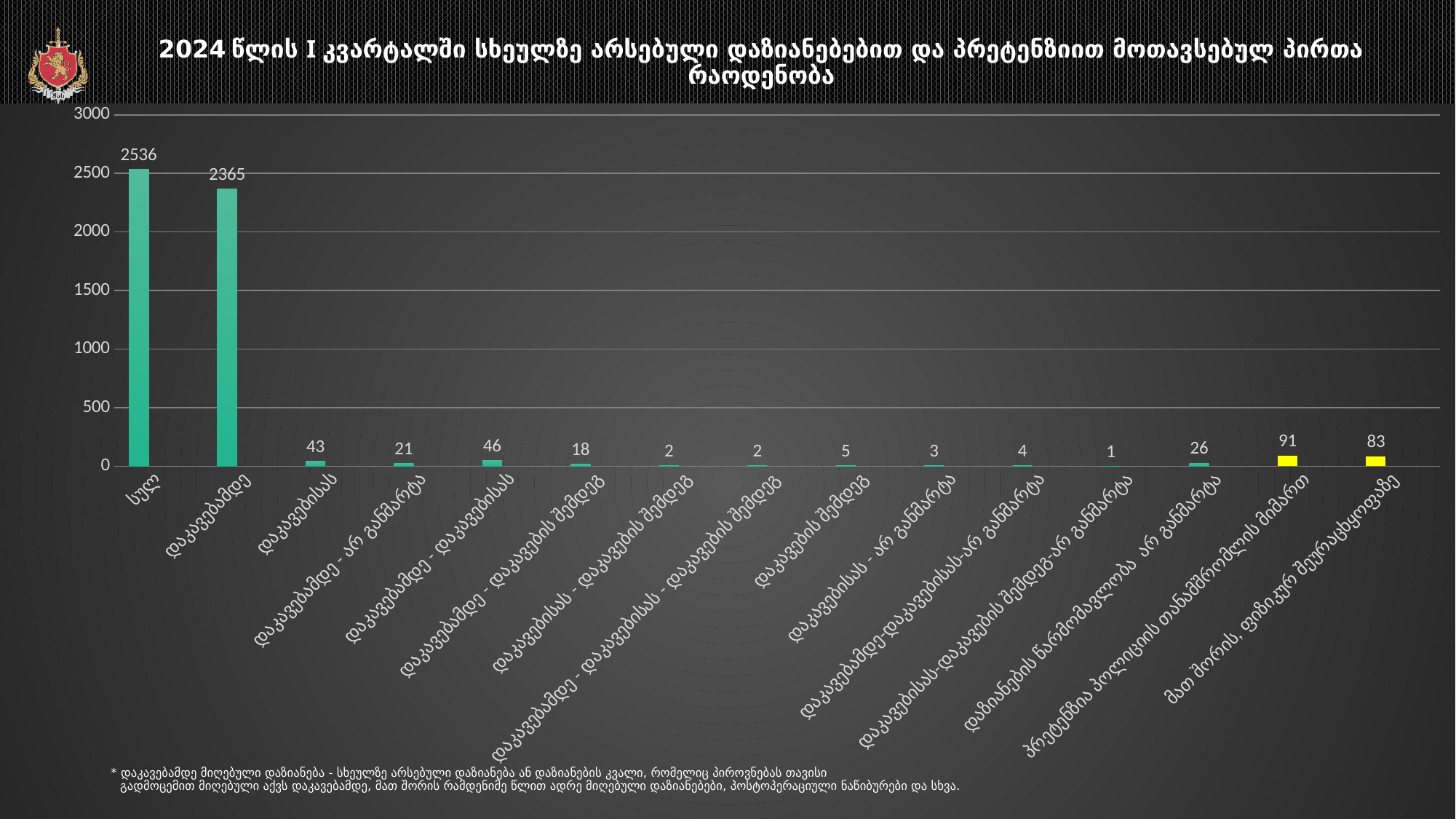
What is the value for the category "სულ"? 2536 Which category has the lowest value? დაკავებისას-დაკავების შემდეგ-არ განმარტა What is the value for the category "მათ შორის, ფიზიკურ შეურაცხყოფაზე"? 83 What is the difference between the values for "სულ" and "დაკავებამდე"? 171 What is the value for the category "დაზიანების წარმოშავლობა არ განმარტა"? 26 Which is larger, the value for "დაკავებისას" or the value for "დაკავებამდე - დაკავებისას"? დაკავებამდე - დაკავებისას What is the value for the category "დაკავებამდე"? 2365 How many categories are shown on the x axis? 15 What is the value for the category "პრეტენზია პოლიციის თანამშრომლის მიმართ"? 91 What is the value for the category "დაკავებისას"? 43 Which category has the highest value? სულ What type of chart is shown on the slide? bar chart